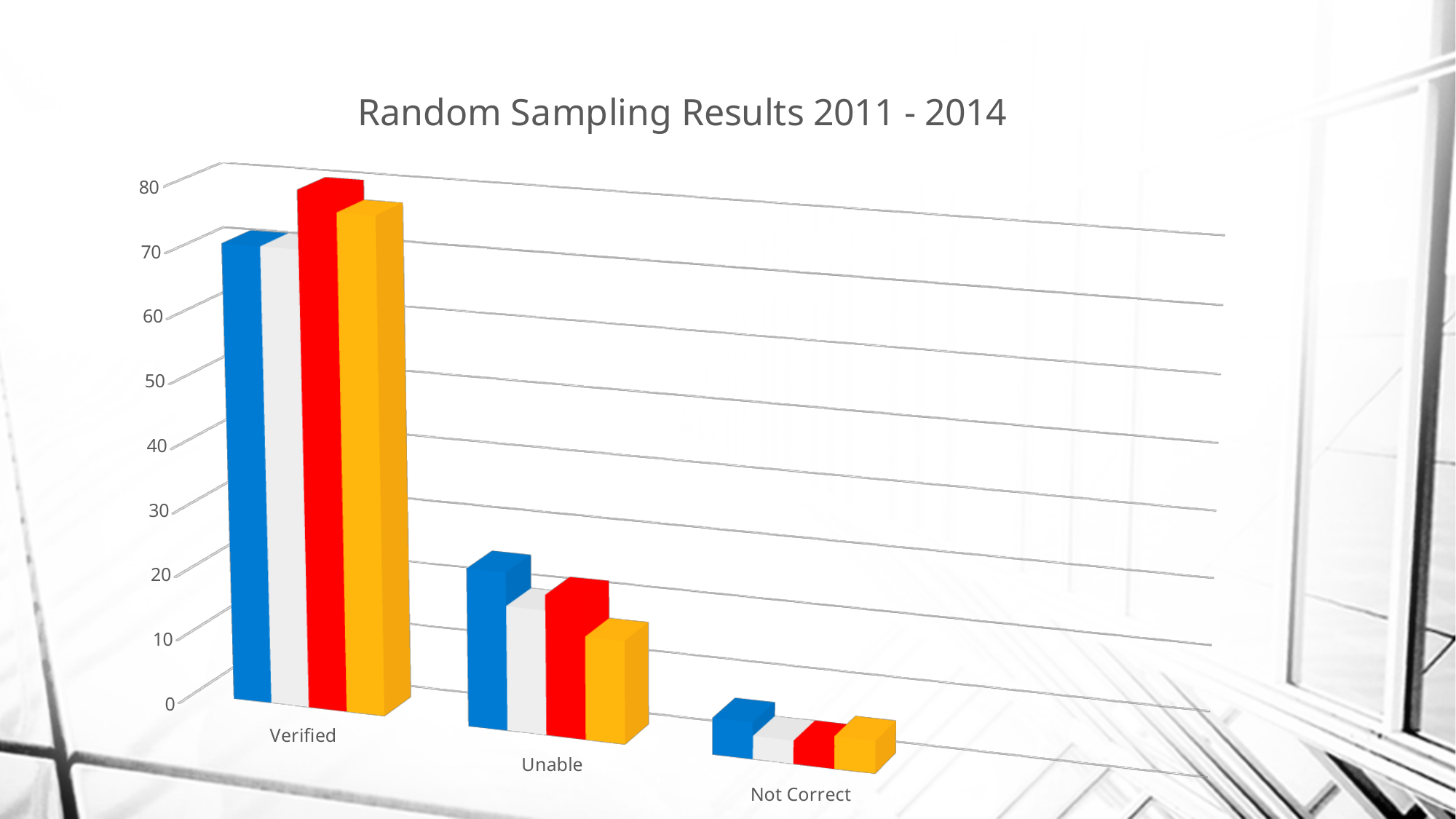
What is the title of the chart? Random Sampling Results 2011 - 2014 Do the values rise or fall moving from Verified to Not Correct along the x axis? fall Is the value of the yellow bar for Not Correct greater or less than 10? less How many categories are shown on the x axis? 3 Is the value of the blue bar for Unable greater or less than 30? less Which category has the lowest bars? Not Correct What kind of chart is shown on the slide? bar chart Is the value of the blue bar for Verified greater or less than 60? greater How many bars are plotted for each category? 4 Which category has the highest bars? Verified Within the Verified category, which is larger: the red bar or the blue bar? the red bar